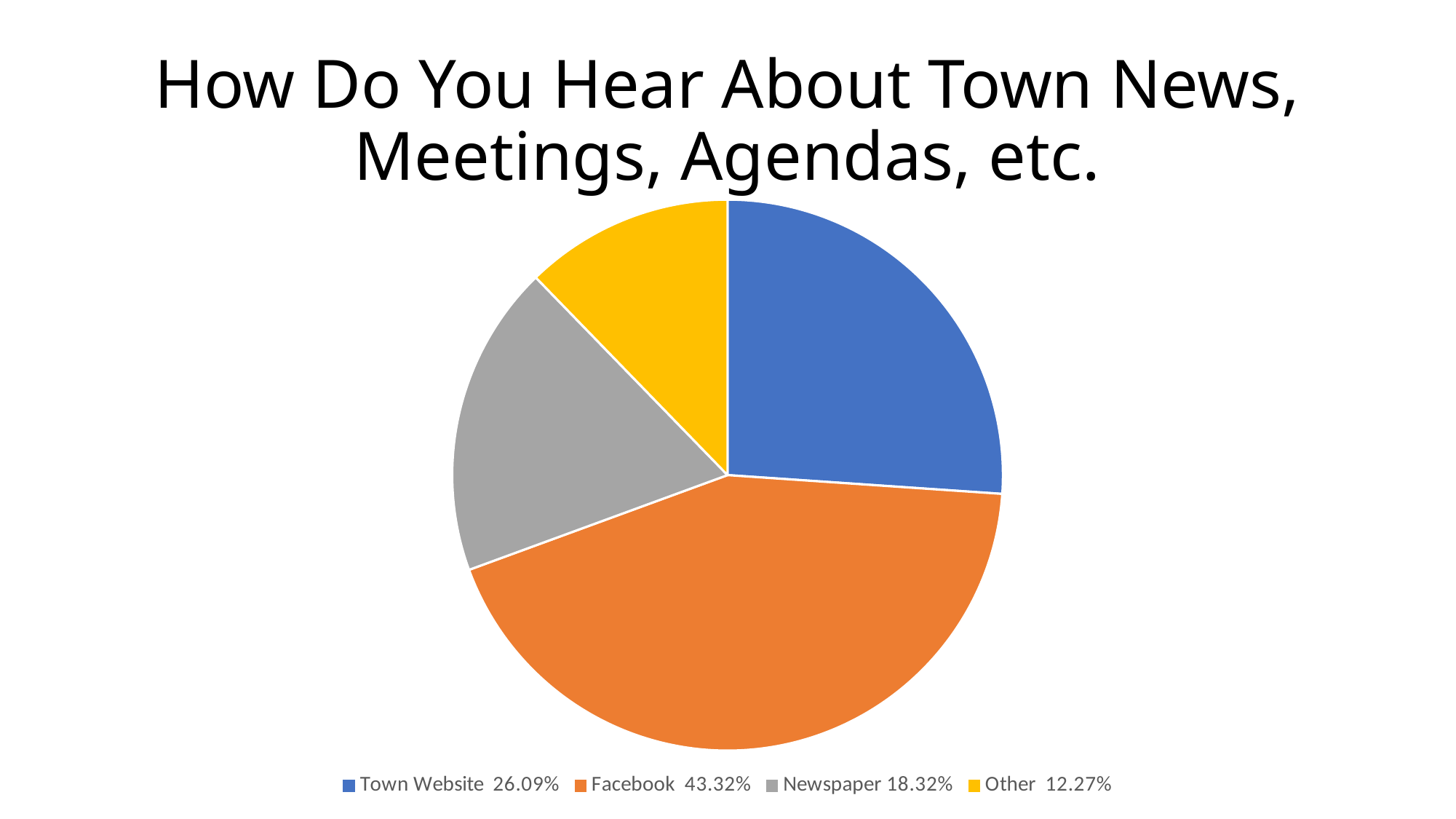
Which category has the largest slice of the pie? Facebook What share of the pie does Town Website represent? 26.09% What is the title of the chart? How Do You Hear About Town News, Meetings, Agendas, etc. What kind of chart is shown on the slide? pie chart What is the difference between the Facebook share and the Town Website share? 17.23% What share of the pie does Newspaper represent? 18.32% How many categories are shown in the pie chart? 4 What share of the pie does Other represent? 12.27% What colour is the Newspaper slice? gray Which is larger, the share for Town Website or the share for Newspaper? Town Website Which category has the smallest slice of the pie? Other